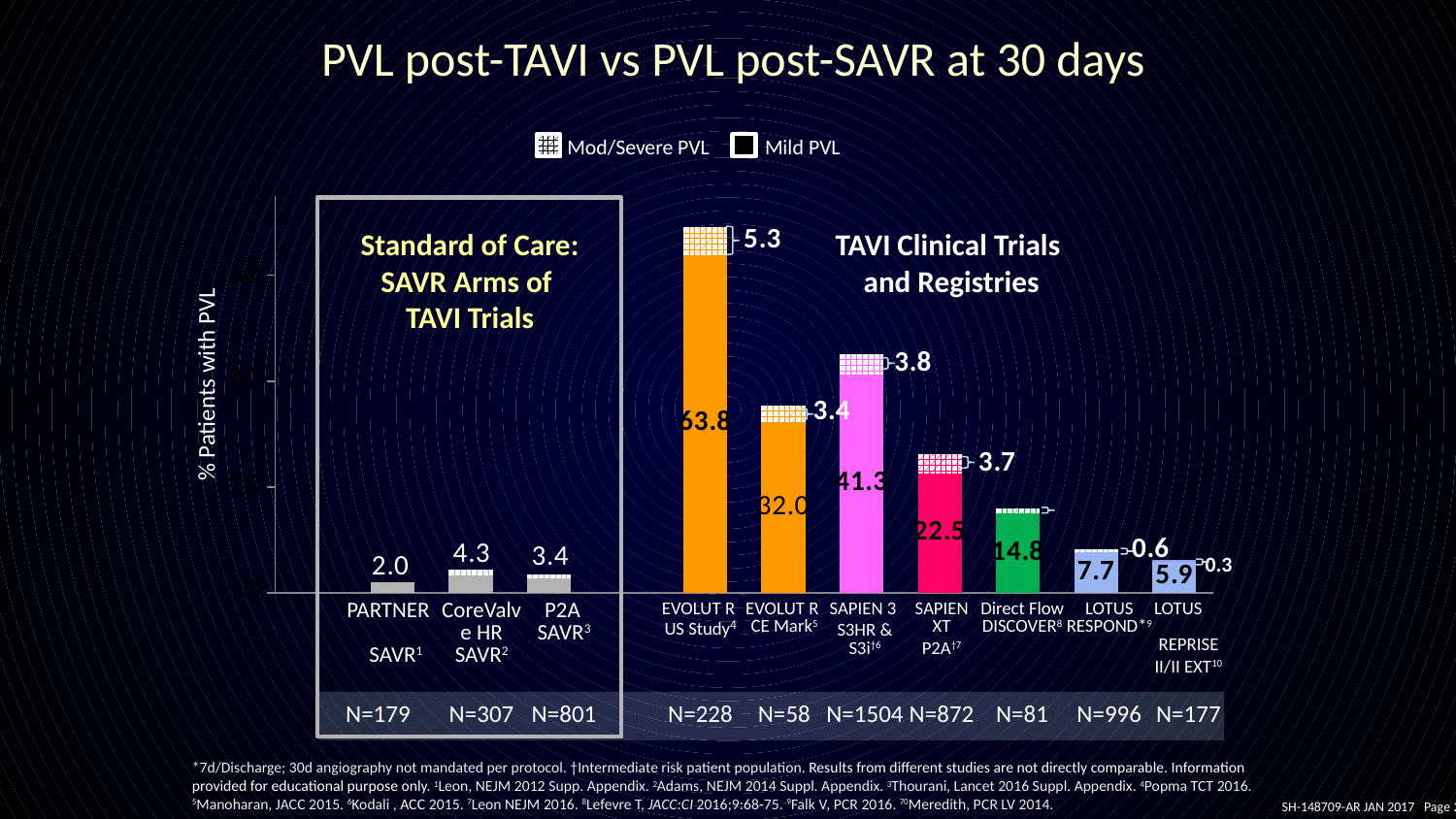
What is the Mild PVL value for the EVOLUT R US Study bar? 63.8 What kind of chart is shown on the slide? Stacked bar chart What sample size (N) is shown for the SAPIEN 3 S3HR & S3i bar? N=1504 What is the total height (Mild plus Mod/Severe PVL) of the EVOLUT R US Study bar? 69.1 How many categories (bars) are shown on the x axis? 10 What is the Mod/Severe PVL value for LOTUS RESPOND? 0.6 Which category has the highest Mild PVL value? EVOLUT R US Study How many series does the legend list? 2 What is the difference between the Mild PVL values of EVOLUT R US Study and EVOLUT R CE Mark? 31.8 What is the Mod/Severe PVL value for the SAPIEN 3 S3HR & S3i bar? 3.8 Which has a larger Mild PVL value, SAPIEN 3 S3HR & S3i or SAPIEN XT P2A? SAPIEN 3 S3HR & S3i Among the three SAVR arms, which has the lowest PVL value? PARTNER SAVR